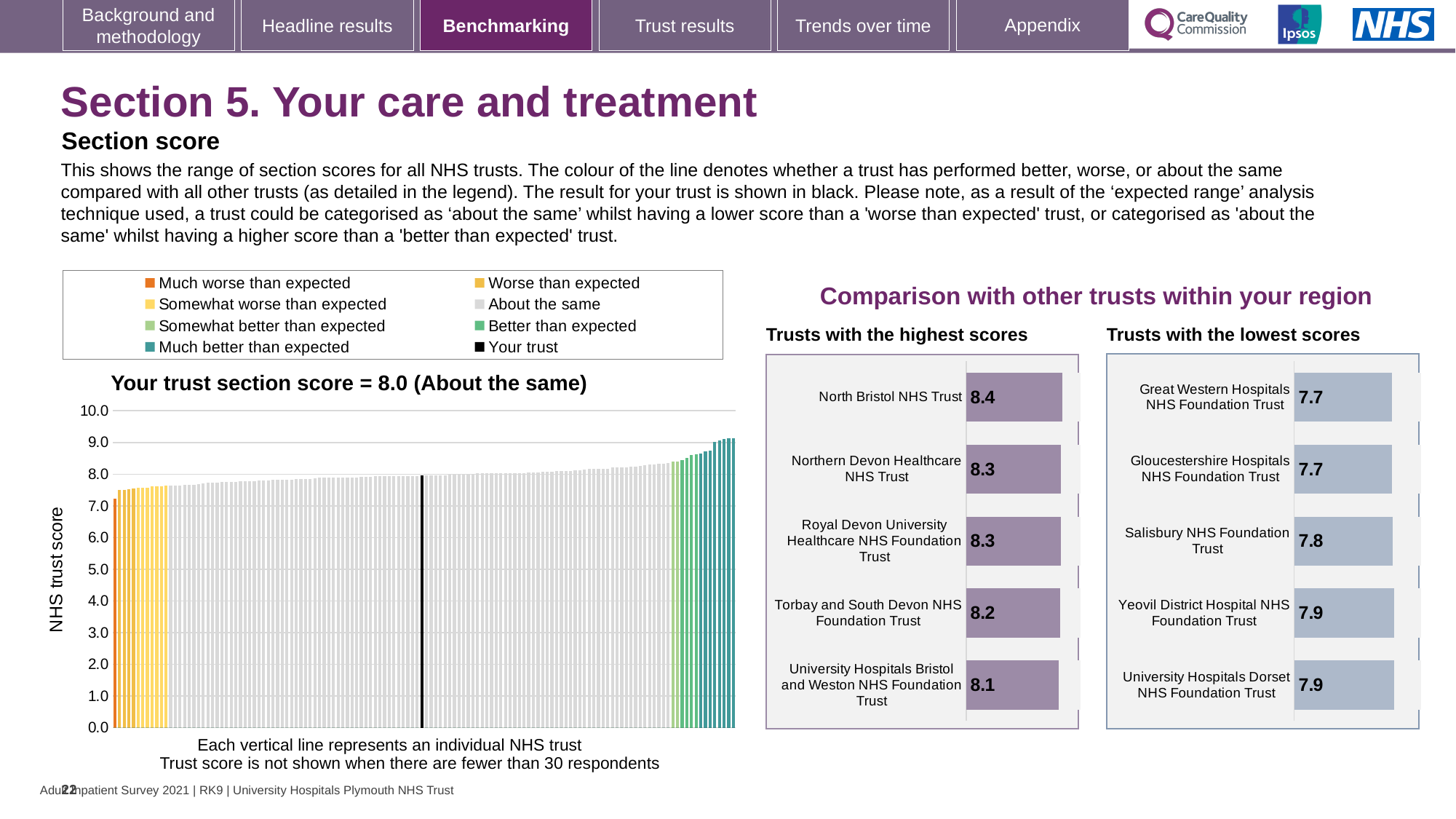
In the 'Trusts with the highest scores' chart, which trust has the highest score? North Bristol NHS Trust How many entries does the legend above the 'Your trust section score' chart list? 8 In the 'Trusts with the highest scores' chart, what is the score for North Bristol NHS Trust? 8.4 In the 'Your trust section score' chart, is the value of the leftmost (orange) bar greater or less than 8.0? less In the 'Trusts with the lowest scores' chart, what is the score for Salisbury NHS Foundation Trust? 7.8 What kind of chart is the 'Your trust section score' chart on the left of the slide? bar chart What is the y-axis label of the 'Your trust section score' chart? NHS trust score In the 'Trusts with the highest scores' chart, what is the difference between the scores of North Bristol NHS Trust and University Hospitals Bristol and Weston NHS Foundation Trust? 0.3 In the 'Your trust section score' chart, do the bars rise or fall from left to right? rise In the 'Trusts with the lowest scores' chart, which has the higher score: Salisbury NHS Foundation Trust or Yeovil District Hospital NHS Foundation Trust? Yeovil District Hospital NHS Foundation Trust In the 'Your trust section score' chart, what is the section score for your trust? 8.0 How many trusts are shown in the 'Trusts with the lowest scores' chart? 5